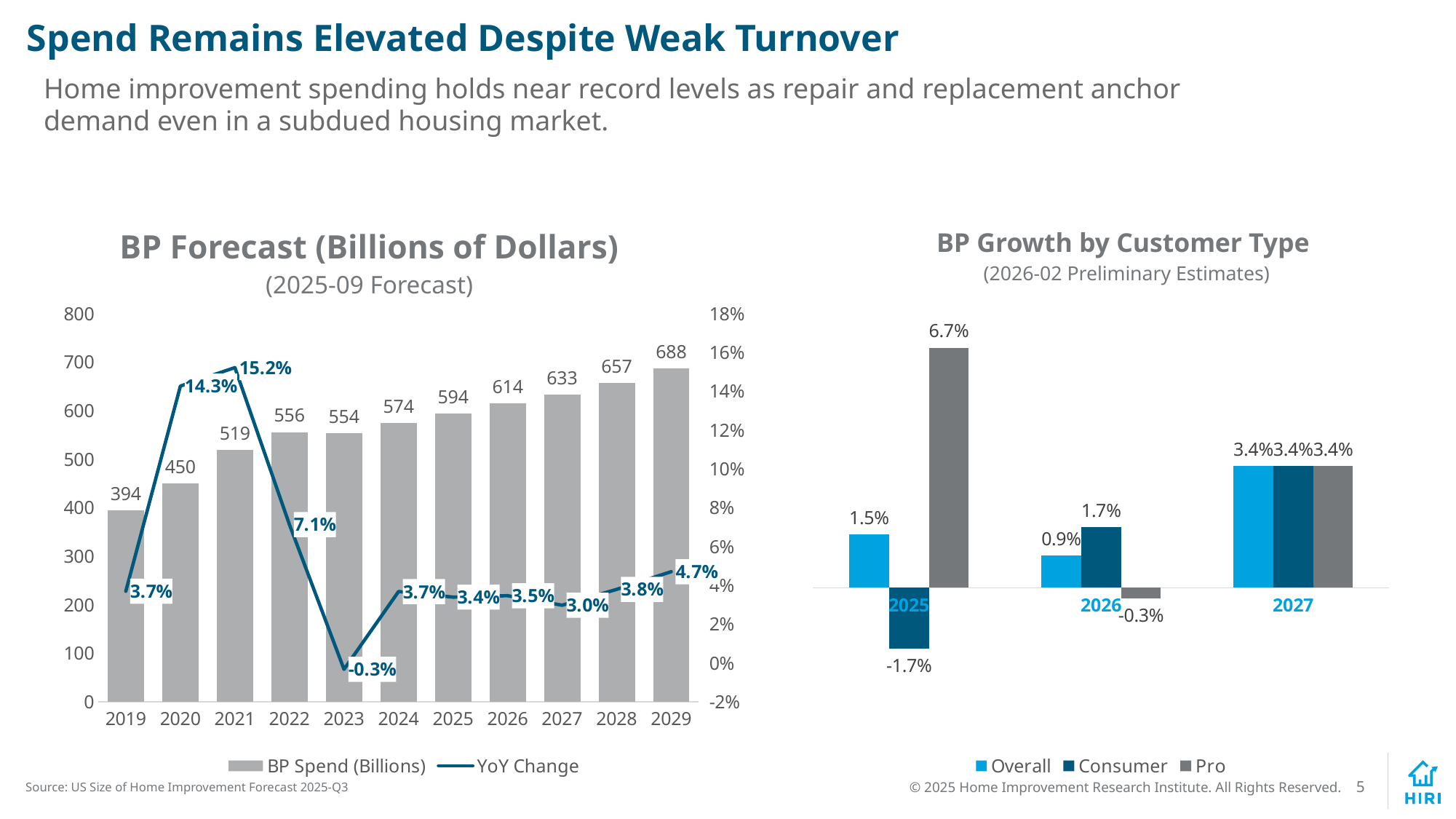
In the BP Forecast (Billions of Dollars) chart, what is the difference in BP Spend between 2029 and 2019? 294 What kind of chart is the BP Growth by Customer Type chart? bar chart In the BP Forecast (Billions of Dollars) chart, how many years are shown on the x axis? 11 In the BP Forecast (Billions of Dollars) chart, do the BP Spend values rise or fall from 2024 to 2029? rise In the BP Forecast (Billions of Dollars) chart, what is the BP Spend value for 2023? 554 In the BP Growth by Customer Type chart, which is larger in 2026, Overall or Consumer? Consumer In the BP Growth by Customer Type chart, what is the Pro value for 2025? 6.7% In the BP Forecast (Billions of Dollars) chart, which year has the highest BP Spend? 2029 In the BP Growth by Customer Type chart, what is the Consumer value for 2025? -1.7% In the BP Forecast (Billions of Dollars) chart, what is the YoY Change for 2021? 15.2% In the BP Forecast (Billions of Dollars) chart, which year has the lowest YoY Change? 2023 In the BP Growth by Customer Type chart, how many series does the legend list? 3